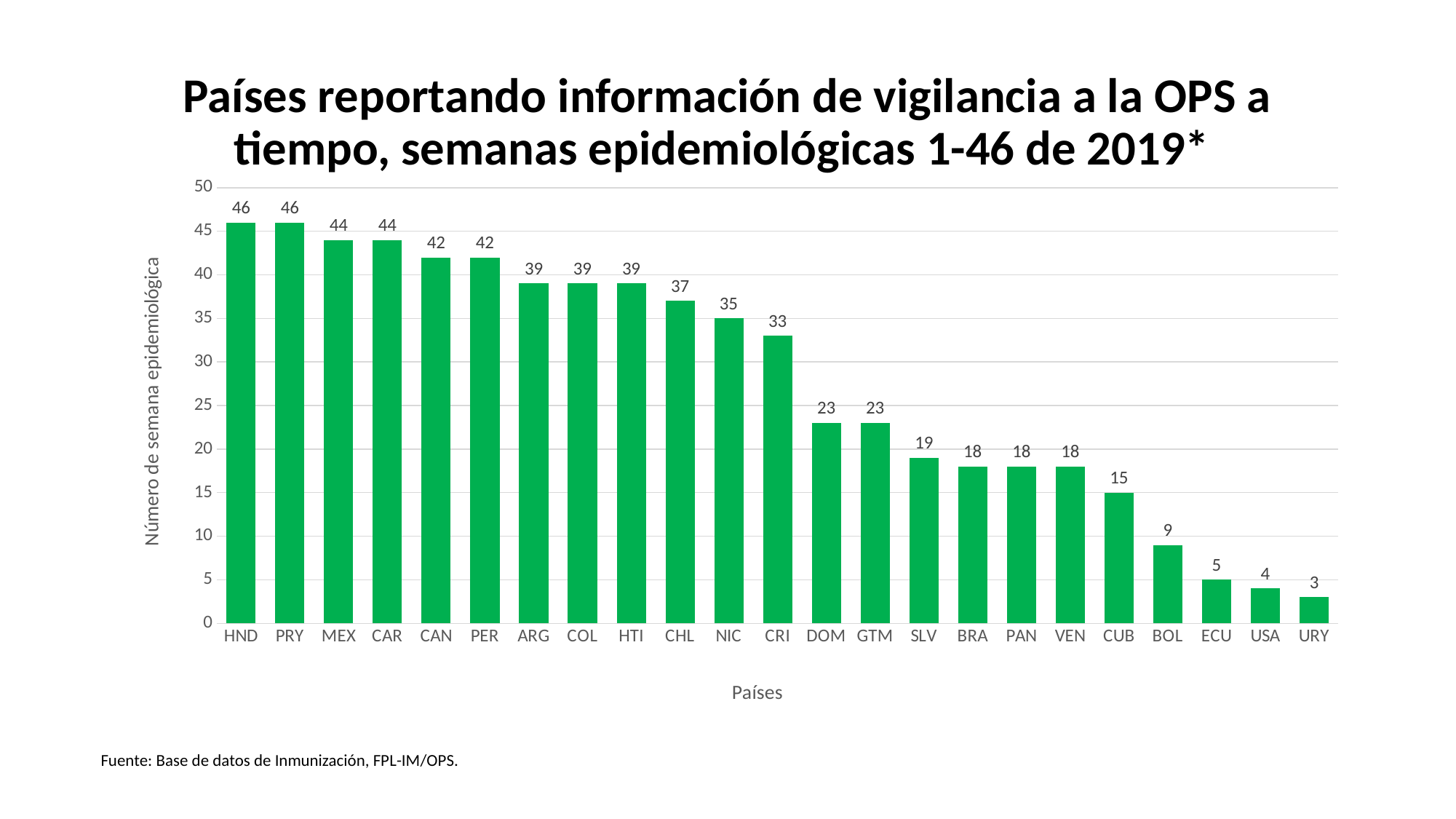
What is the value for USA? 4 Which has a larger value, NIC or SLV? NIC What is the difference between the values for HND and BOL? 37 What is the value for CUB? 15 What kind of chart is shown on the slide? bar chart What is the label of the y axis? Número de semana epidemiológica Is the value for GTM greater or less than 25? less What is the value for MEX? 44 What is the value for CHL? 37 Which country has the lowest value? URY What is the difference between the values for CRI and DOM? 10 How many countries are shown on the x axis? 23